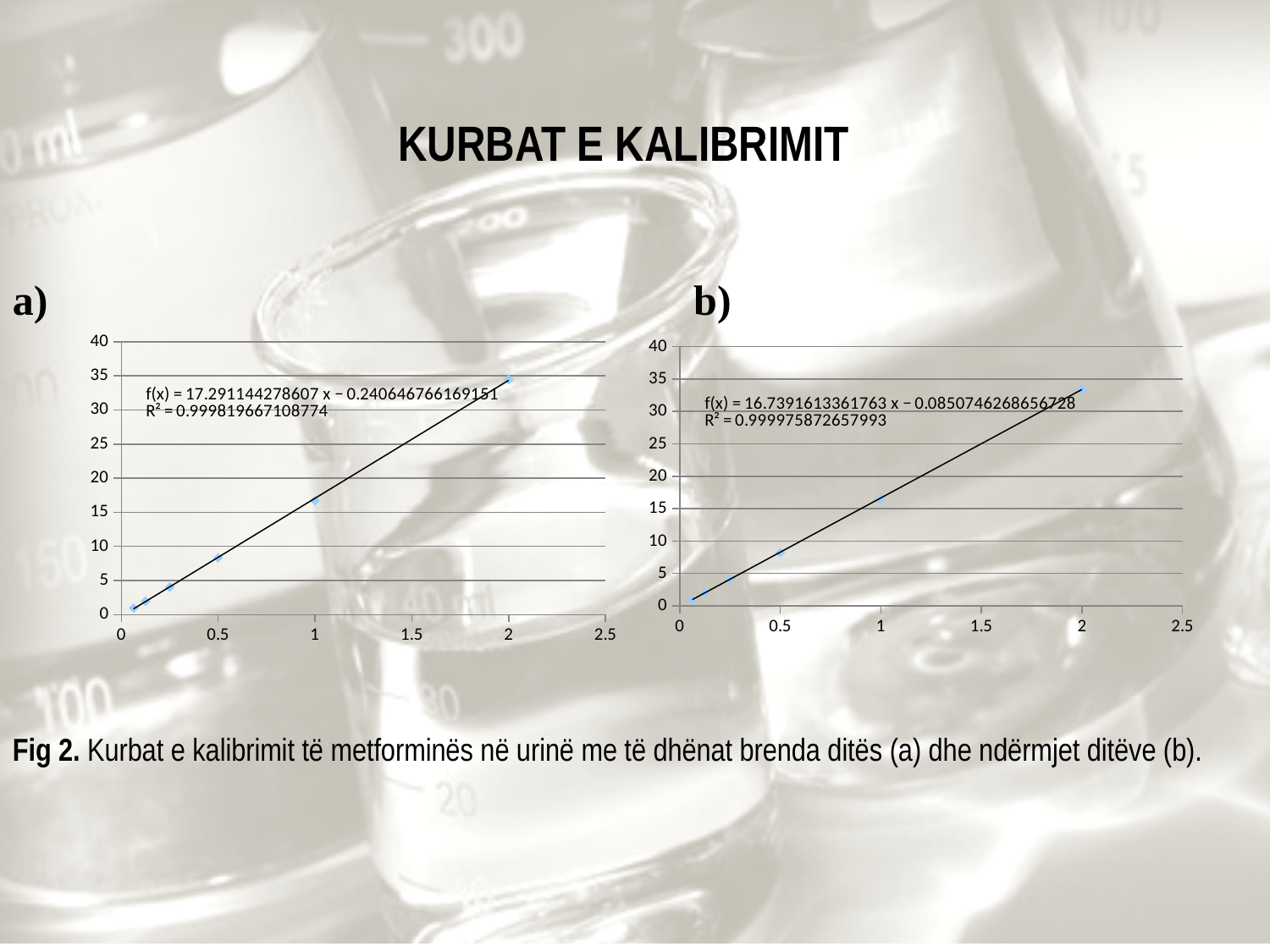
In chart a), do the plotted values rise or fall as x increases? rise In chart b), which is larger: the value at x = 1 or the value at x = 0.5? x = 1 In chart a), is the value at x = 2 greater or less than 30? greater What type of chart is chart a) on the slide? scatter chart with a trendline In chart b), is the value at x = 2 greater or less than 30? greater What is the title of the slide containing the two charts? KURBAT E KALIBRIMIT In chart b), do the plotted values rise or fall as x increases? rise In chart a), what R² value is printed on the chart? R² = 0.999819667108774 In chart a), is the value at x = 1 greater or less than 20? less In chart b), what is the slope in the printed trendline equation f(x)? 16.7391613361763 In chart a), which x value has the highest plotted point? 2